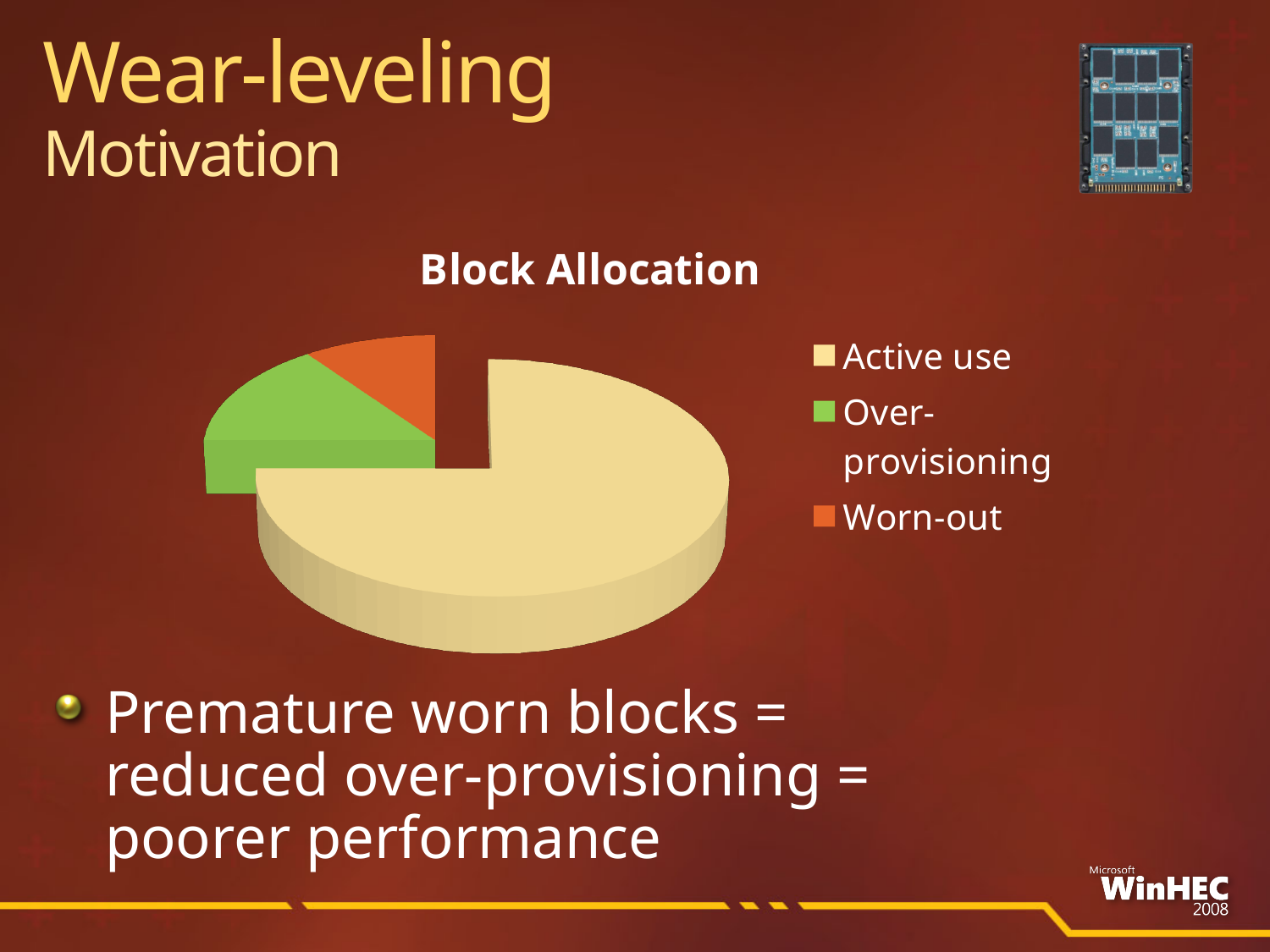
What colour is the Worn-out slice in the pie chart? orange What is the title of the chart? Block Allocation Which category takes up the largest share of the pie? Active use Which slice is larger, Over-provisioning or Worn-out? Over-provisioning Which slice is larger, Active use or Over-provisioning? Active use How many slices does the pie chart have? 3 Which category takes up the smallest share of the pie? Worn-out Does the Active use slice take up more or less than half of the pie? more What kind of chart is shown on the slide? pie chart How many entries does the chart legend list? 3